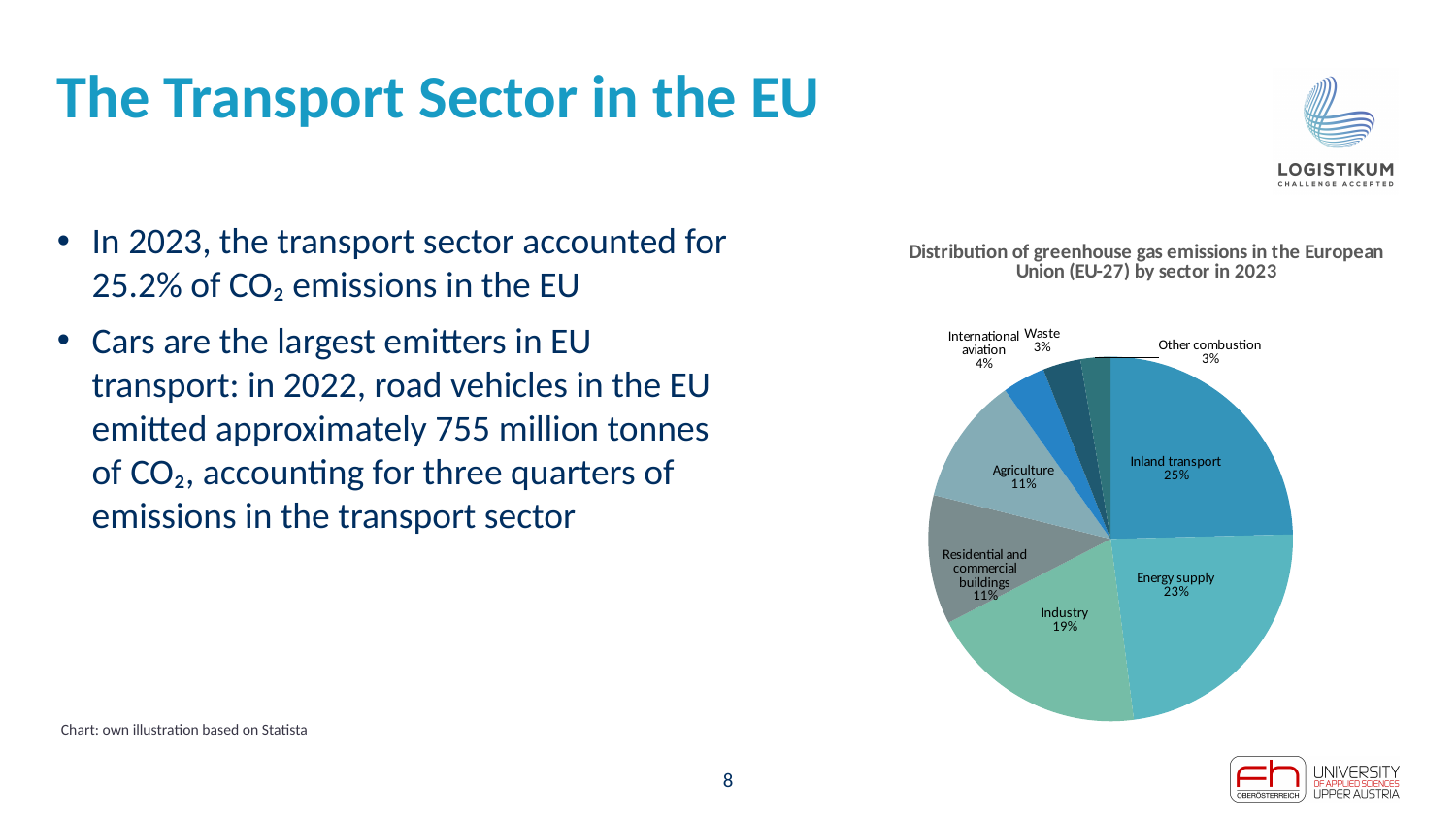
What is the title of the pie chart? Distribution of greenhouse gas emissions in the European Union (EU-27) by sector in 2023 What share of greenhouse gas emissions does Inland transport account for in the pie chart? 25% What share is shown for International aviation in the pie chart? 4% What is the share of Industry in the pie chart? 19% Which sector has the largest slice in the pie chart? Inland transport What percentage does Agriculture represent in the pie chart? 11% What type of chart is shown on the slide? Pie chart How many sectors are shown in the pie chart? 8 Which is larger in the pie chart, Industry or Agriculture? Industry What is the difference between the shares of Industry and Residential and commercial buildings in the pie chart? 8 percentage points By how many percentage points does Inland transport exceed Energy supply in the pie chart? 2 percentage points What percentage of emissions is attributed to Energy supply in the pie chart? 23%